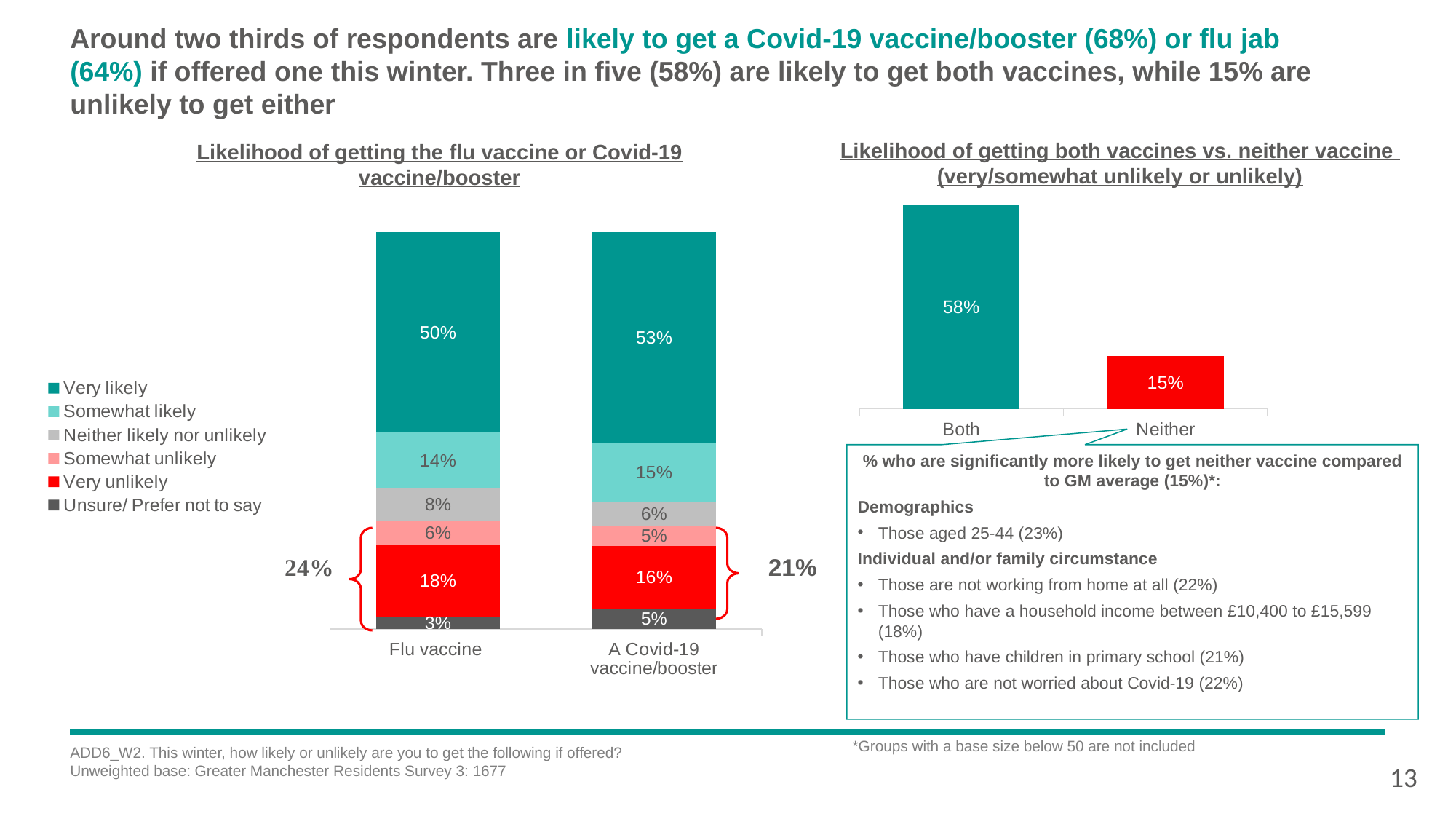
In the chart titled 'Likelihood of getting both vaccines vs. neither vaccine', what percentage are likely to get both vaccines? 58% In the chart titled 'Likelihood of getting both vaccines vs. neither vaccine', how many bars are shown? 2 In the chart titled 'Likelihood of getting the flu vaccine or Covid-19 vaccine/booster', what is the difference between the 'Very likely' values for the Covid-19 vaccine/booster and the flu vaccine? 3% In the chart titled 'Likelihood of getting the flu vaccine or Covid-19 vaccine/booster', how many series does the legend list? 6 In the chart titled 'Likelihood of getting the flu vaccine or Covid-19 vaccine/booster', what is the 'Unsure/ Prefer not to say' value for the flu vaccine? 3% In the chart titled 'Likelihood of getting the flu vaccine or Covid-19 vaccine/booster', what percentage are very unlikely to get a Covid-19 vaccine/booster? 16% In the chart titled 'Likelihood of getting the flu vaccine or Covid-19 vaccine/booster', what kind of chart is shown? Stacked bar chart In the chart titled 'Likelihood of getting the flu vaccine or Covid-19 vaccine/booster', what colour represents 'Very unlikely'? Red In the chart titled 'Likelihood of getting both vaccines vs. neither vaccine', what percentage are likely to get neither vaccine? 15% In the chart titled 'Likelihood of getting both vaccines vs. neither vaccine', what is the difference between the 'Both' and 'Neither' values? 43% In the chart titled 'Likelihood of getting the flu vaccine or Covid-19 vaccine/booster', what percentage of respondents are very likely to get the flu vaccine? 50% In the chart titled 'Likelihood of getting the flu vaccine or Covid-19 vaccine/booster', which has the larger 'Somewhat likely' value, the flu vaccine or the Covid-19 vaccine/booster? A Covid-19 vaccine/booster